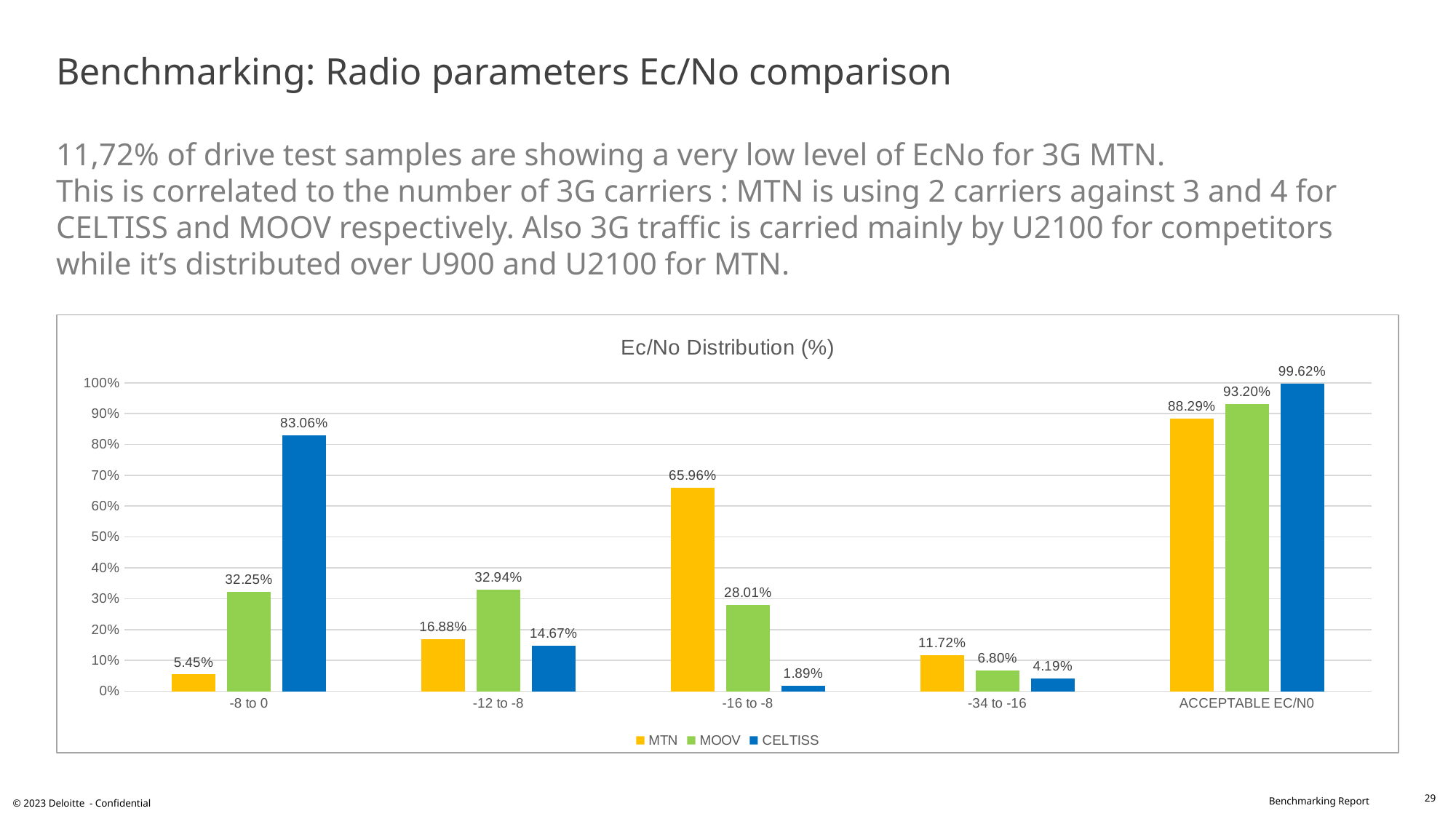
What type of chart is shown on the slide? Bar chart Is the MOOV value for the -12 to -8 category greater or less than 30%? greater What is the MTN value for the -34 to -16 category? 11.72% How many series does the legend list? 3 Which series has the highest value in the -16 to -8 category? MTN What is the CELTISS value for the -8 to 0 category? 83.06% Which is larger in the -12 to -8 category, the MTN value or the CELTISS value? MTN What is the difference between the MTN and MOOV values in the -16 to -8 category? 37.95% How many categories are shown on the x axis? 5 What is the difference between the CELTISS and MTN values in the ACCEPTABLE EC/N0 category? 11.33% What is the MOOV value for the ACCEPTABLE EC/N0 category? 93.20% Which series has the lowest value in the -8 to 0 category? MTN